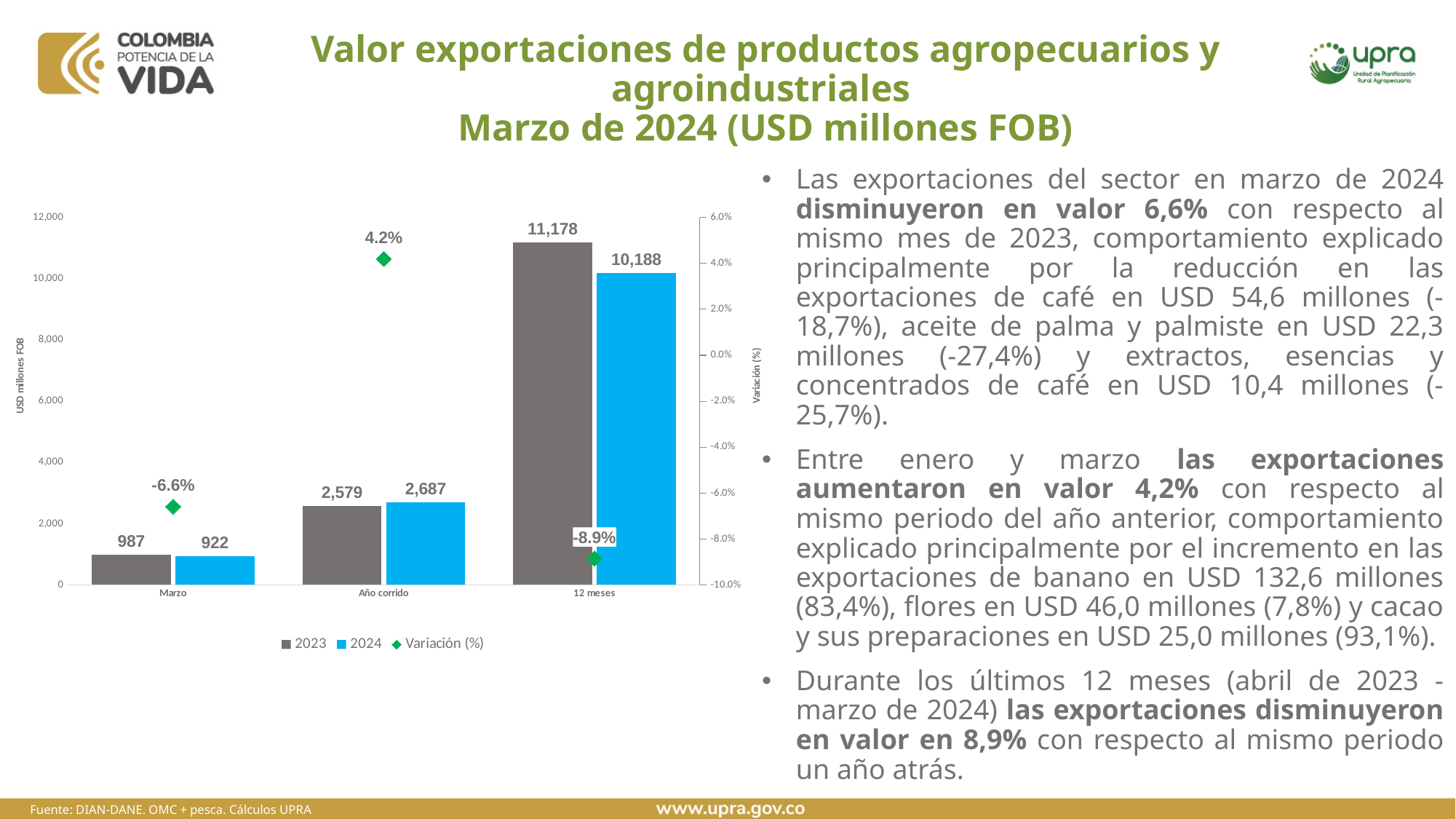
What is the difference between the 2023 and 2024 values for 12 meses? 990 What is the 2023 value for Marzo? 987 Which is larger for Año corrido, the 2023 value or the 2024 value? 2024 Which category has the highest 2023 value? 12 meses What is the Variación (%) value for Año corrido? 4.2% How many series does the legend list? 3 What is the 2024 value for Año corrido? 2,687 What kind of chart is used for the 2023 and 2024 series? Bar chart Which category has the lowest 2024 value? Marzo How many categories are shown on the x axis? 3 What is the Variación (%) value for 12 meses? -8.9% What is the 2024 value for 12 meses? 10,188